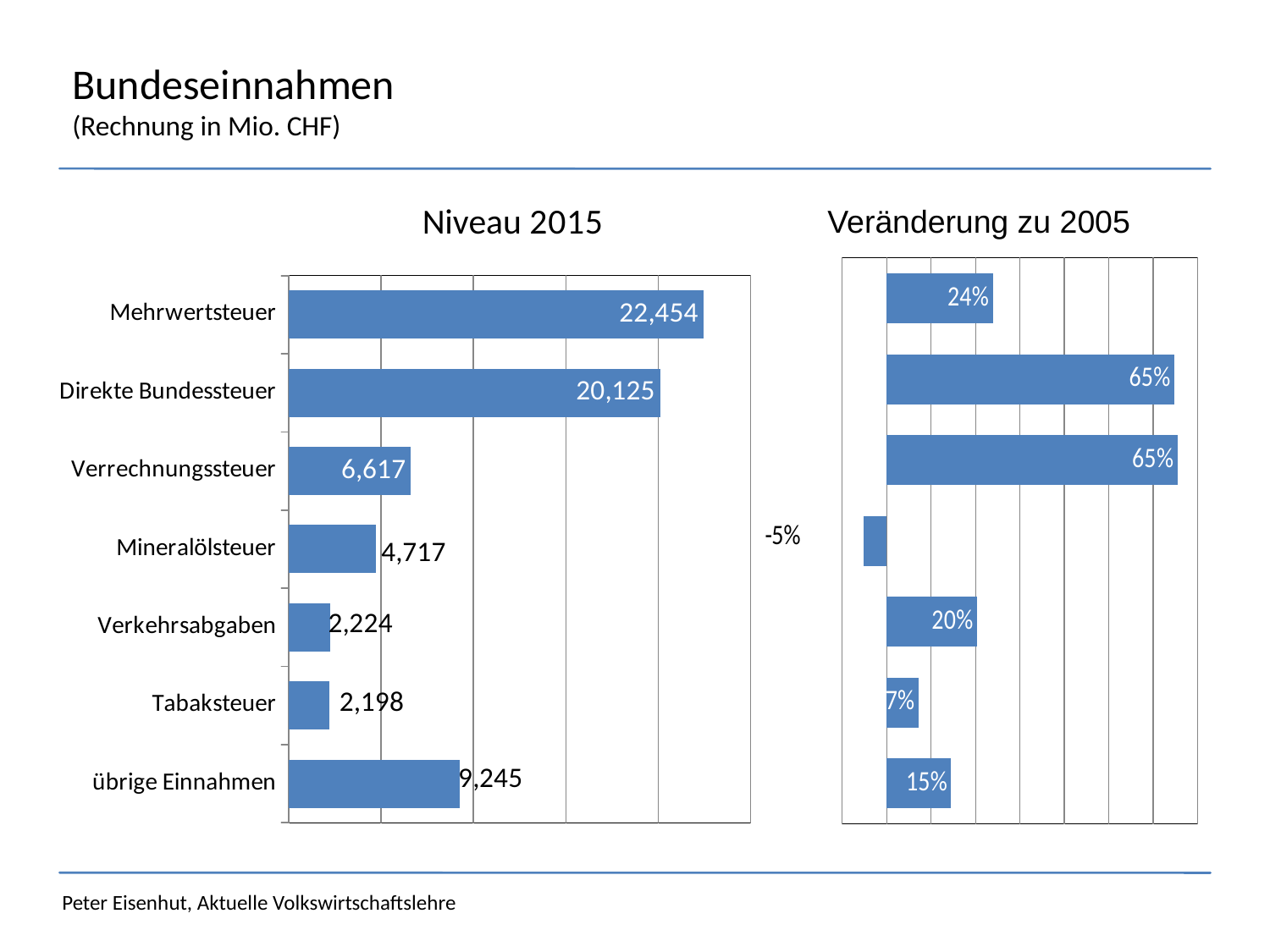
In the Niveau 2015 chart, which category has the lowest value? Tabaksteuer In the Veränderung zu 2005 chart, what is the value for Mineralölsteuer? -5% What kind of chart is the Veränderung zu 2005 chart? Bar chart In the Niveau 2015 chart, which category has the highest value? Mehrwertsteuer How many categories are shown in the Niveau 2015 chart? 7 In the Veränderung zu 2005 chart, which category has the lowest value? Mineralölsteuer In the Niveau 2015 chart, which is larger, Verrechnungssteuer or Mineralölsteuer? Verrechnungssteuer In the Veränderung zu 2005 chart, what is the value for Tabaksteuer? 7% In the Niveau 2015 chart, what is the value for übrige Einnahmen? 9,245 In the Niveau 2015 chart, what is the difference between Mehrwertsteuer and Direkte Bundessteuer? 2,329 In the Niveau 2015 chart, what is the value for Mehrwertsteuer? 22,454 In the Veränderung zu 2005 chart, what is the difference between Mehrwertsteuer and Verkehrsabgaben? 4%